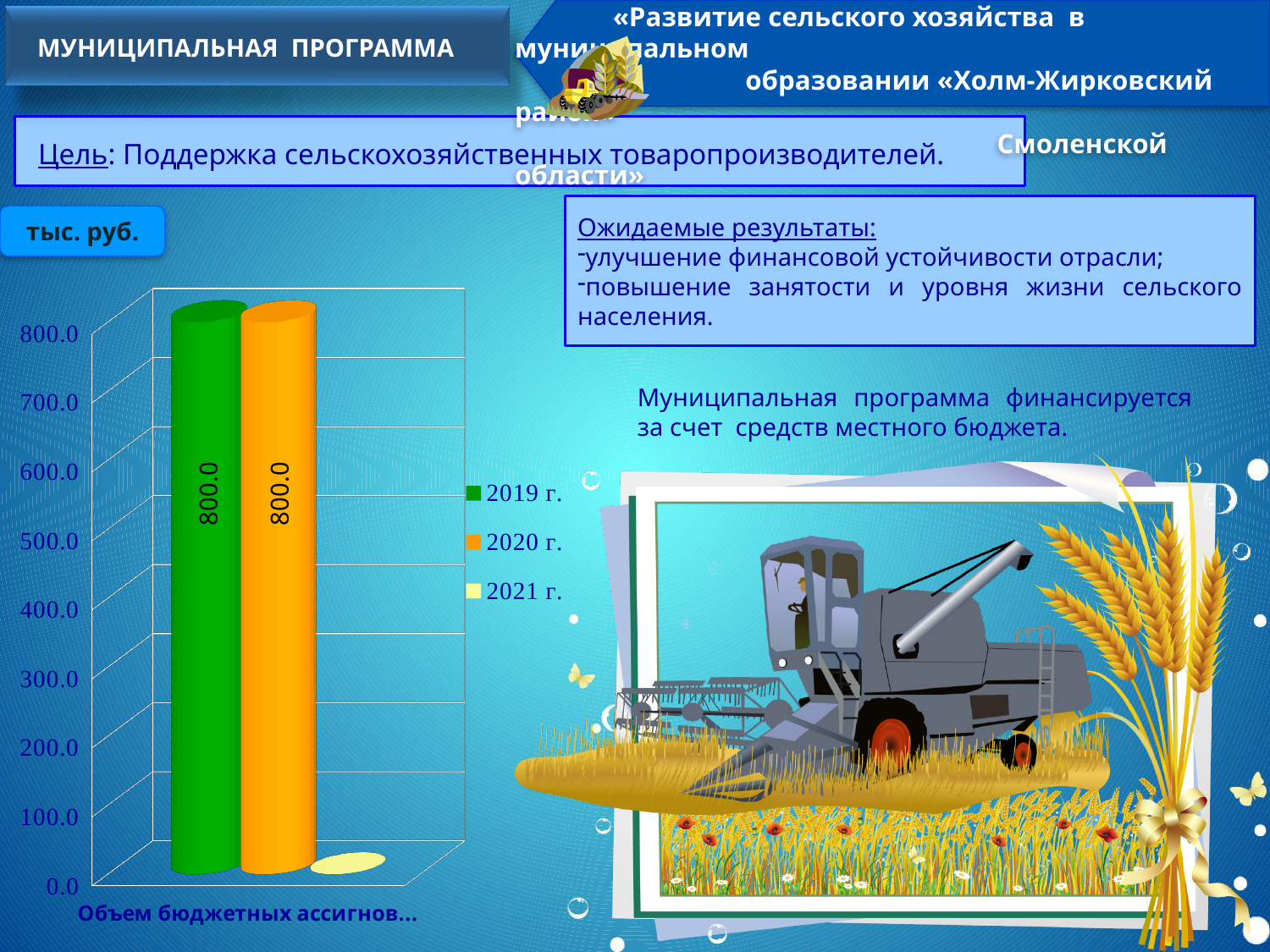
Is the value for 2019 г. greater or less than 700.0? greater What is the difference between the values for 2019 г. and 2020 г.? 0.0 How many series does the chart legend list? 3 Which series has the lowest value in the chart? 2021 г. Is the value for 2020 г. larger than, smaller than, or equal to the value for 2019 г.? equal What is the value for 2020 г. in the chart? 800.0 Is the value for 2021 г. greater or less than 100.0? less Which colour represents 2020 г. in the legend? orange What unit is indicated for the chart values? тыс. руб. What is the highest tick value shown on the vertical axis? 800.0 What kind of chart is shown on the slide? bar chart What is the value for 2019 г. in the chart? 800.0